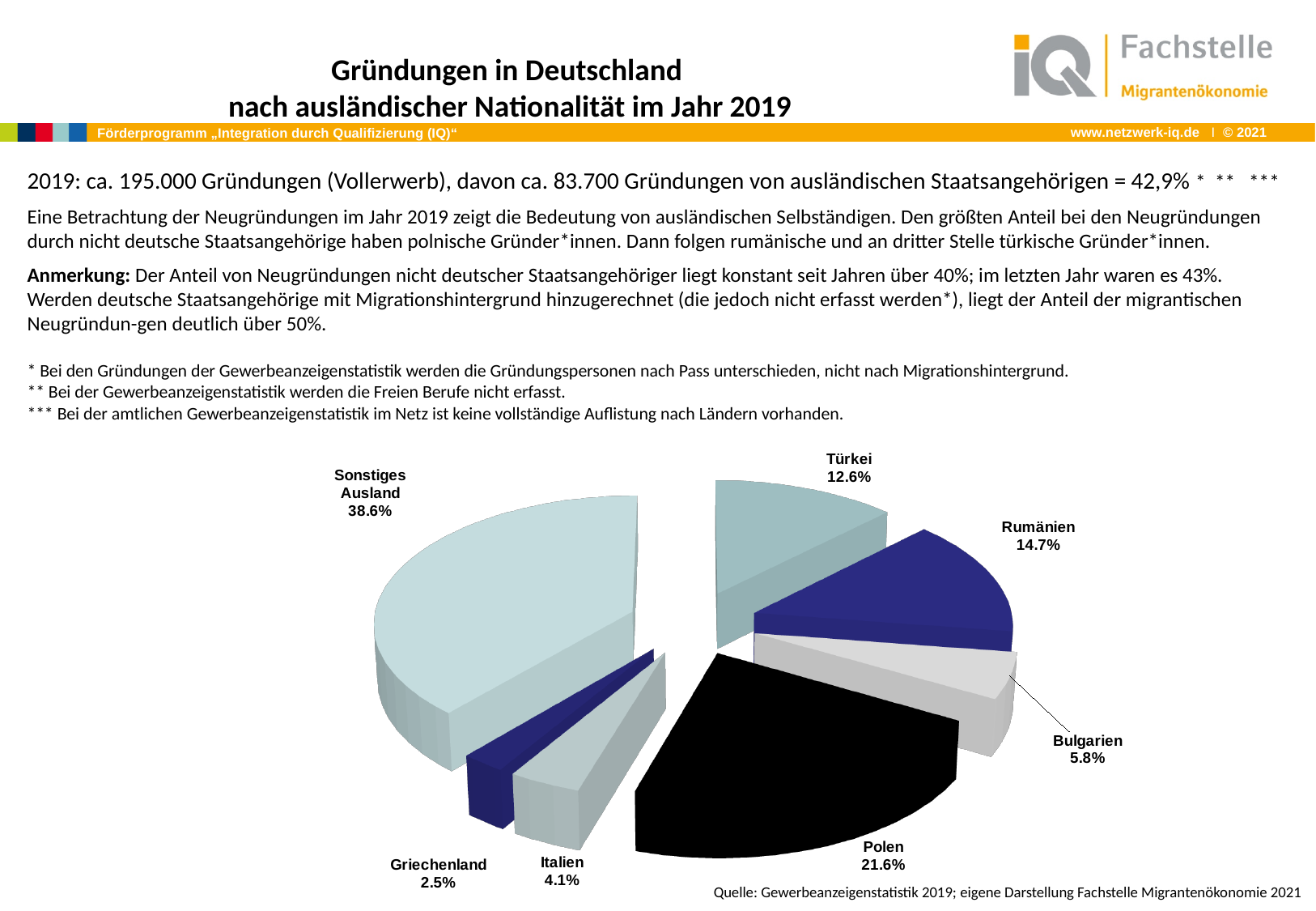
Which slice of the pie chart is coloured black? Polen What is the difference in percentage points between Polen and Türkei? 9.0 How many slices does the pie chart have? 7 Which slice of the pie chart is the largest? Sonstiges Ausland What share of the pie does Polen have? 21.6% What kind of chart is shown on the slide? pie chart What is the value shown for Rumänien? 14.7% What is the difference in percentage points between Italien and Griechenland? 1.6 What is the value shown for Griechenland? 2.5% Which slice of the pie chart is the smallest? Griechenland Which is larger, the share for Türkei or the share for Rumänien? Rumänien What is the value shown for Bulgarien? 5.8%